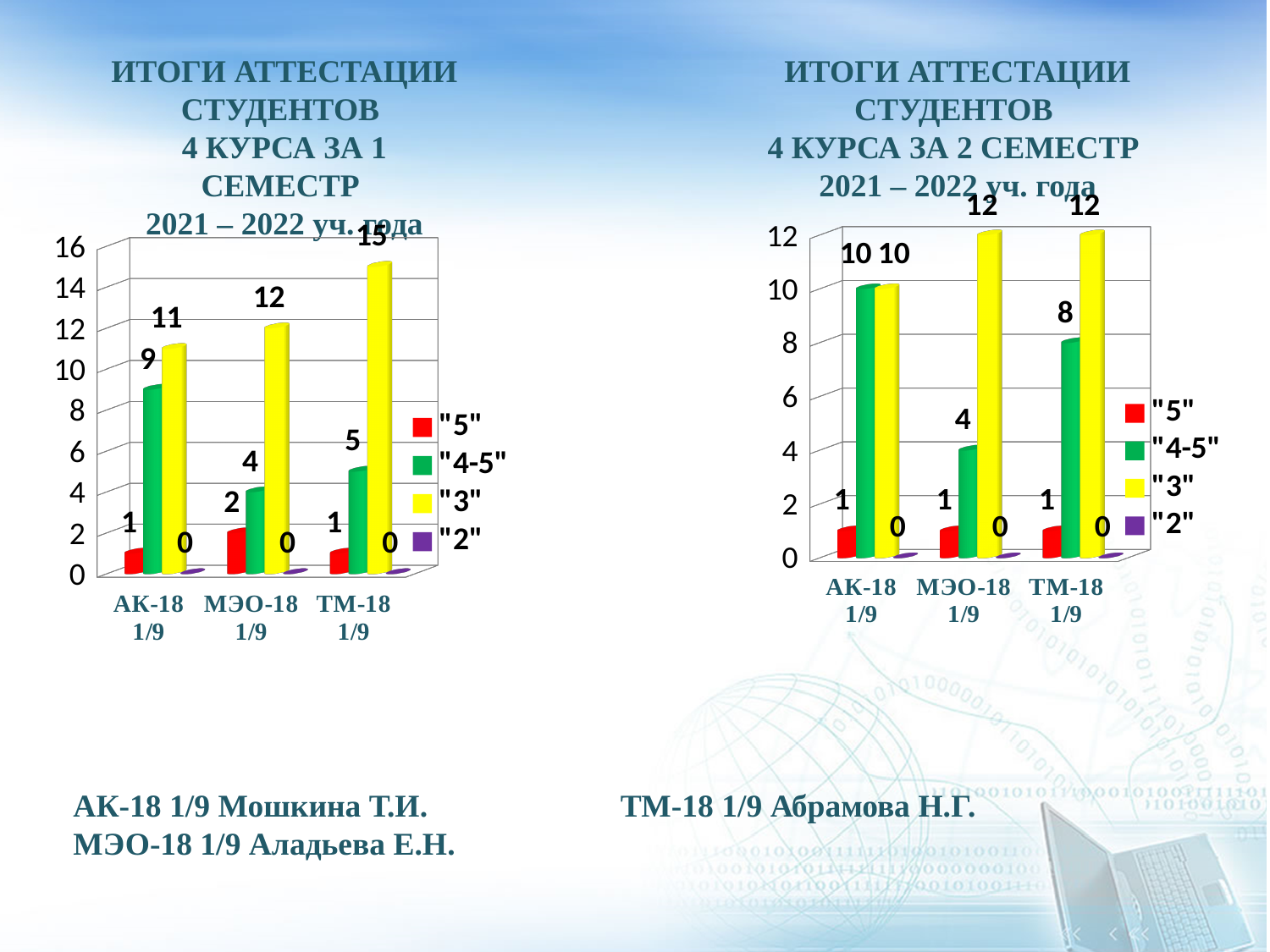
In the left chart (1st semester), what is the value of "4-5" for АК-18 1/9? 9 In the right chart (2nd semester), what is the value of "4-5" for ТМ-18 1/9? 8 What type of chart is the left chart (1st semester)? Bar chart How many groups are shown on the x axis of the left chart (1st semester)? 3 In the right chart (2nd semester), which group has the lowest value for "4-5"? МЭО-18 1/9 In the left chart (1st semester), what is the difference between the "3" values for ТМ-18 1/9 and АК-18 1/9? 4 In the left chart (1st semester), which group has the highest value for "3"? ТМ-18 1/9 In the right chart (2nd semester), what colour represents the "3" series? Yellow In the right chart (2nd semester), which is larger for АК-18 1/9: the "4-5" value or the "3" value? They are equal (10) How many series does the legend of the right chart (2nd semester) list? 4 In the right chart (2nd semester), what is the value of "3" for МЭО-18 1/9? 12 In the left chart (1st semester), what is the value of "3" for ТМ-18 1/9? 15